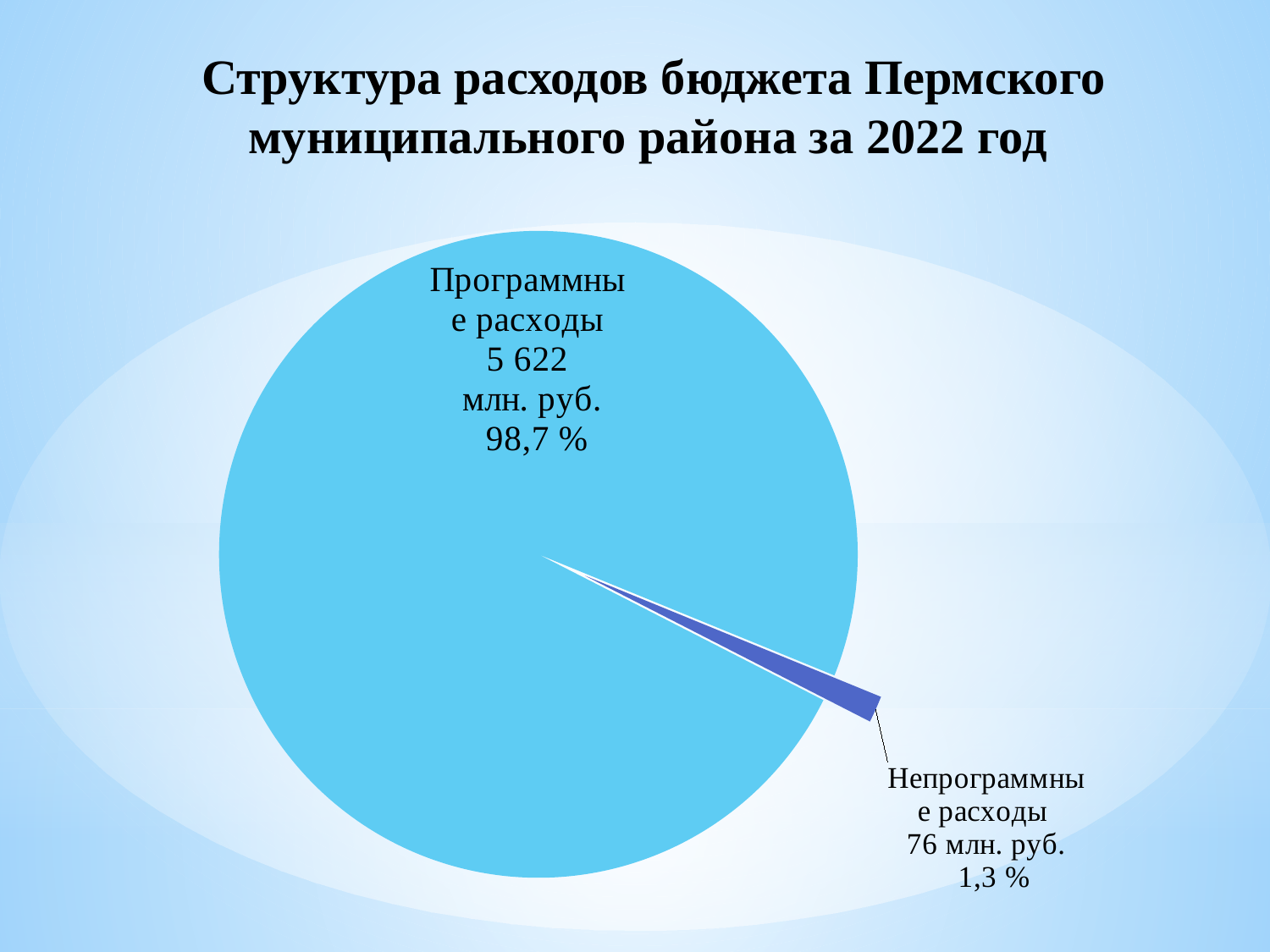
What is the value for Программные расходы? 5 622 млн. руб. What is the difference in млн. руб. between Программные расходы and Непрограммные расходы? 5 546 млн. руб. Which category has the smallest slice of the pie? Непрограммные расходы What is the value for Непрограммные расходы? 76 млн. руб. What is the total of the two slices in млн. руб.? 5 698 млн. руб. What share of the pie does Программные расходы take? 98,7 % How many slices does the pie chart have? 2 Which is larger, Программные расходы or Непрограммные расходы? Программные расходы What share of the pie does Непрограммные расходы take? 1,3 % Which category has the largest slice of the pie? Программные расходы What is the title of the slide? Структура расходов бюджета Пермского муниципального района за 2022 год What kind of chart is shown on the slide? pie chart